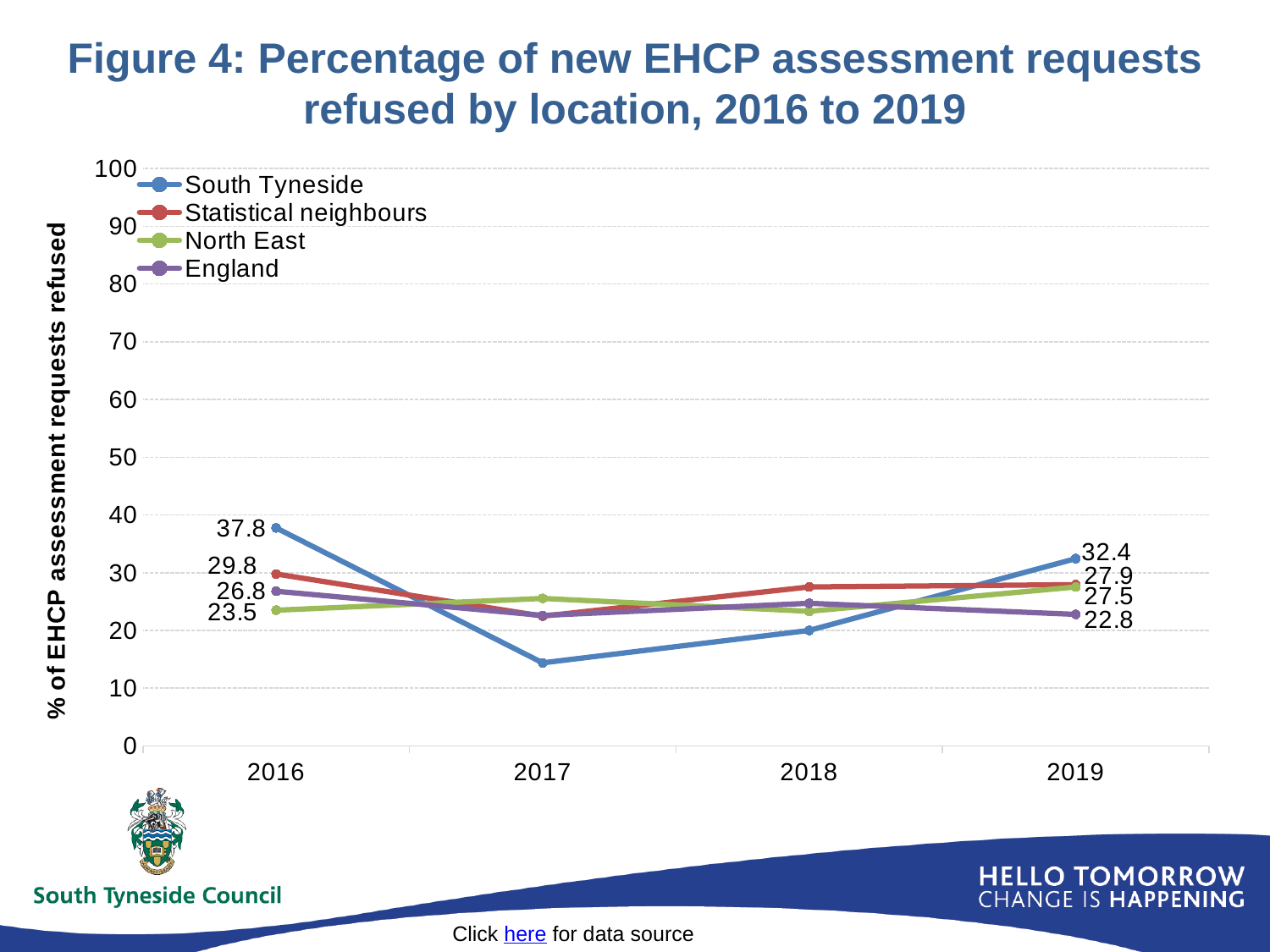
What is the value for England in 2019? 22.8 Which location had the highest percentage of refused requests in 2016? South Tyneside What is the title of the y axis? % of EHCP assessment requests refused How many series does the legend list? 4 How many years are shown on the x axis? 4 Is the value for South Tyneside in 2017 greater or less than 20? less What is the value for South Tyneside in 2016? 37.8 What is the value for North East in 2016? 23.5 What kind of chart is shown on the slide? Line chart What is the value for Statistical neighbours in 2016? 29.8 What is the value for South Tyneside in 2019? 32.4 What is the difference between the South Tyneside values in 2016 and 2019? 5.4